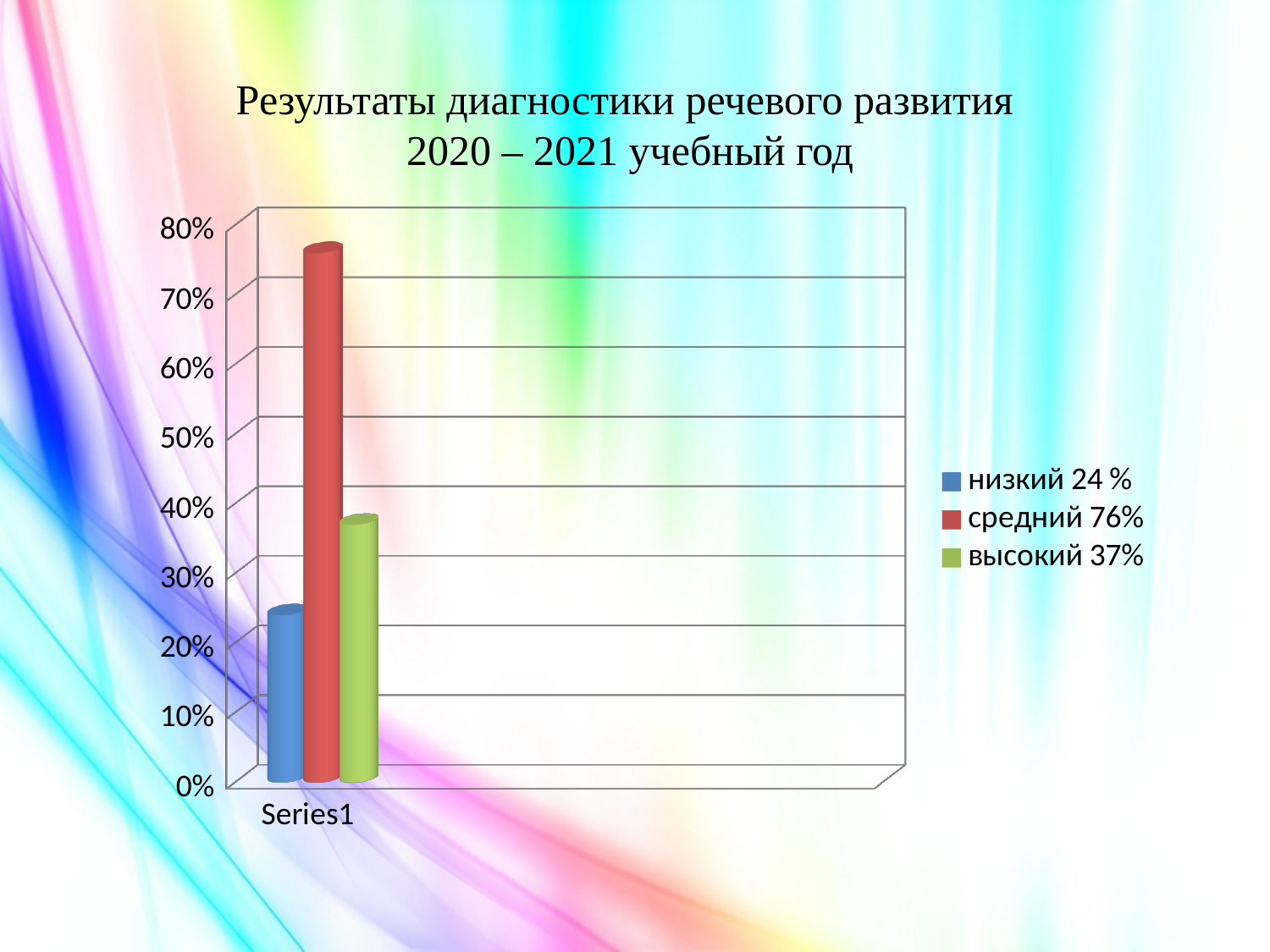
What is the difference between the values for "высокий" and "низкий"? 13% Which series has the highest value? средний What is the difference between the values for "средний" and "низкий"? 52% What value is shown for the series "высокий"? 37% What value is shown for the series "средний"? 76% Which is larger, the value for "высокий" or the value for "низкий"? высокий What is the title of the chart on the slide? Результаты диагностики речевого развития 2020 – 2021 учебный год What value is shown for the series "низкий"? 24 % How many series does the legend list? 3 What kind of chart is shown on the slide? bar chart Is the value for "средний" greater or less than 70%? greater Which series has the lowest value? низкий